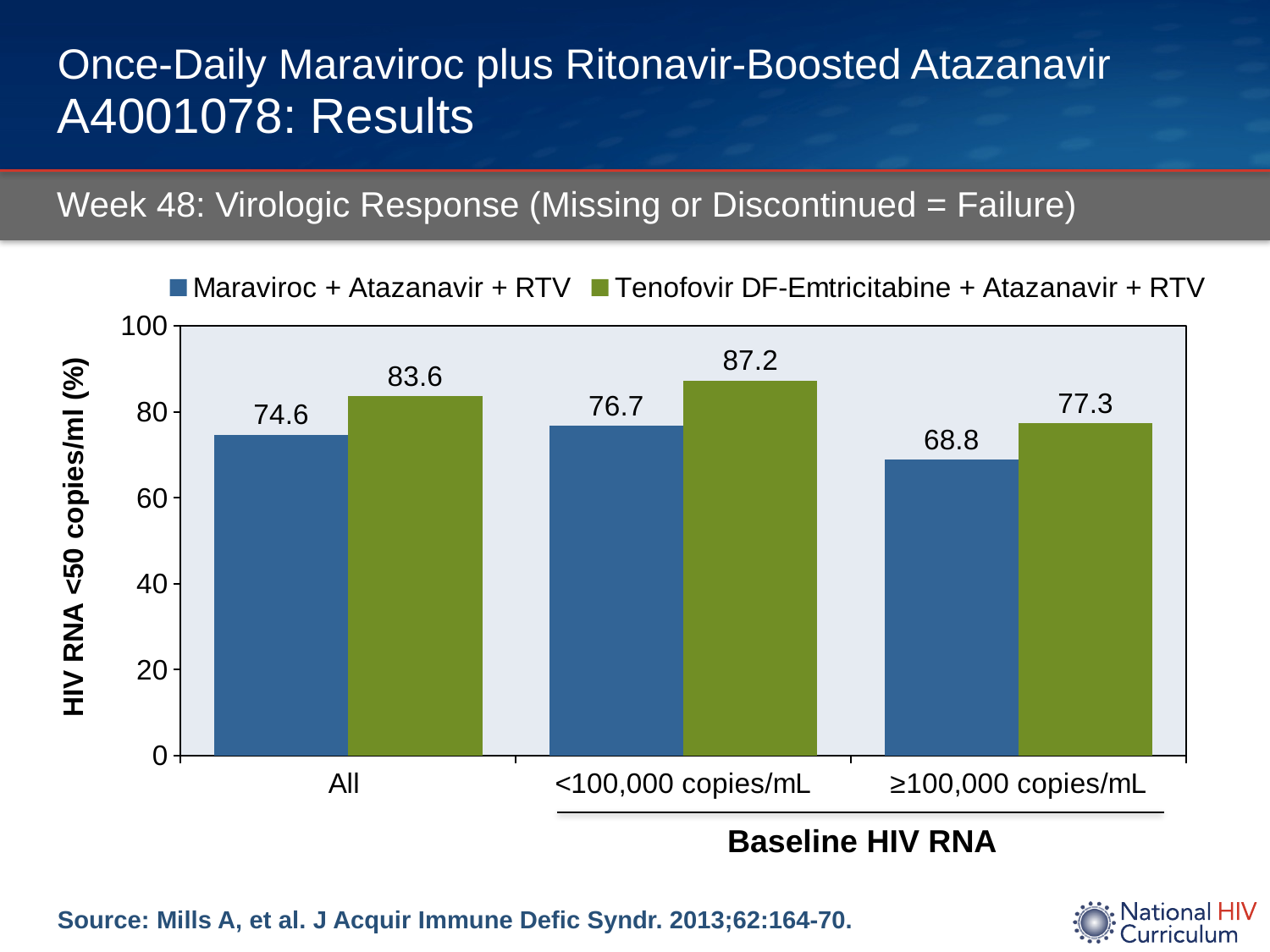
Is the value for Maraviroc + Atazanavir + RTV in the ≥100,000 copies/mL category greater or less than 80? less What is the value for Maraviroc + Atazanavir + RTV in the ≥100,000 copies/mL category? 68.8 Which category has the highest value for Tenofovir DF-Emtricitabine + Atazanavir + RTV? <100,000 copies/mL What is the difference between the two series in the ≥100,000 copies/mL category? 8.5 What kind of chart is shown on the slide? bar chart How many categories are shown on the x axis? 3 How many series does the legend list? 2 In the <100,000 copies/mL category, which series has the larger value? Tenofovir DF-Emtricitabine + Atazanavir + RTV What is the difference between the two series in the All category? 9.0 What is the value for Maraviroc + Atazanavir + RTV in the All category? 74.6 Which category has the lowest value for Maraviroc + Atazanavir + RTV? ≥100,000 copies/mL What is the value for Tenofovir DF-Emtricitabine + Atazanavir + RTV in the <100,000 copies/mL category? 87.2